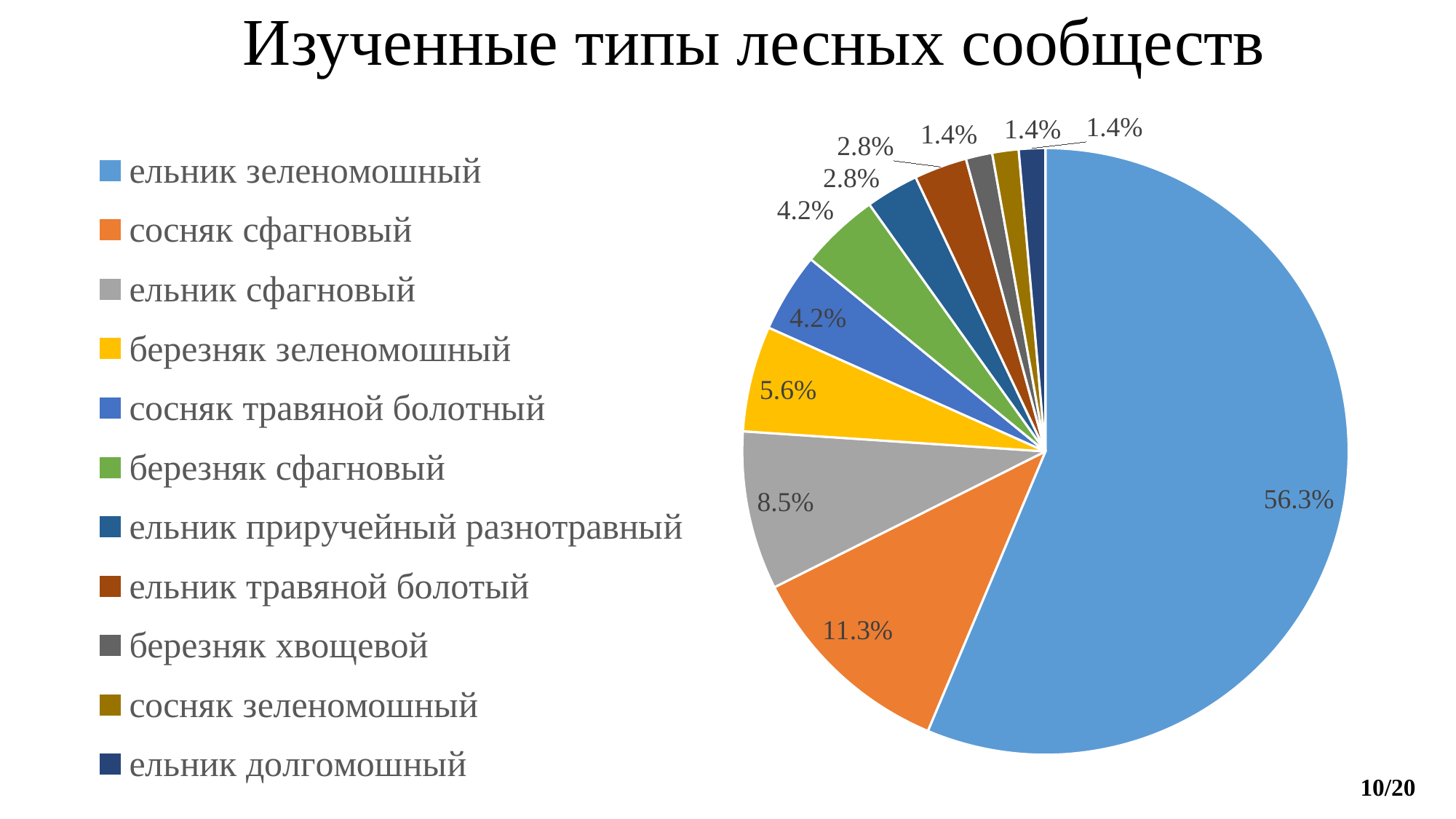
What is the value for сосняк сфагновый? 11.3% What is the title of the chart? Изученные типы лесных сообществ What share of the pie does ельник зеленомошный have? 56.3% Is the share for ельник зеленомошный greater or less than 50%? greater What is the value for ельник сфагновый? 8.5% Which category has the largest share of the pie? ельник зеленомошный How many categories does the pie chart have? 11 What is the value for березняк зеленомошный? 5.6% What is the difference between the shares of ельник зеленомошный and сосняк сфагновый? 45.0% What is the value for ельник травяной болотый? 2.8% Which is larger, сосняк сфагновый or ельник сфагновый? сосняк сфагновый What type of chart is shown on the slide? pie chart